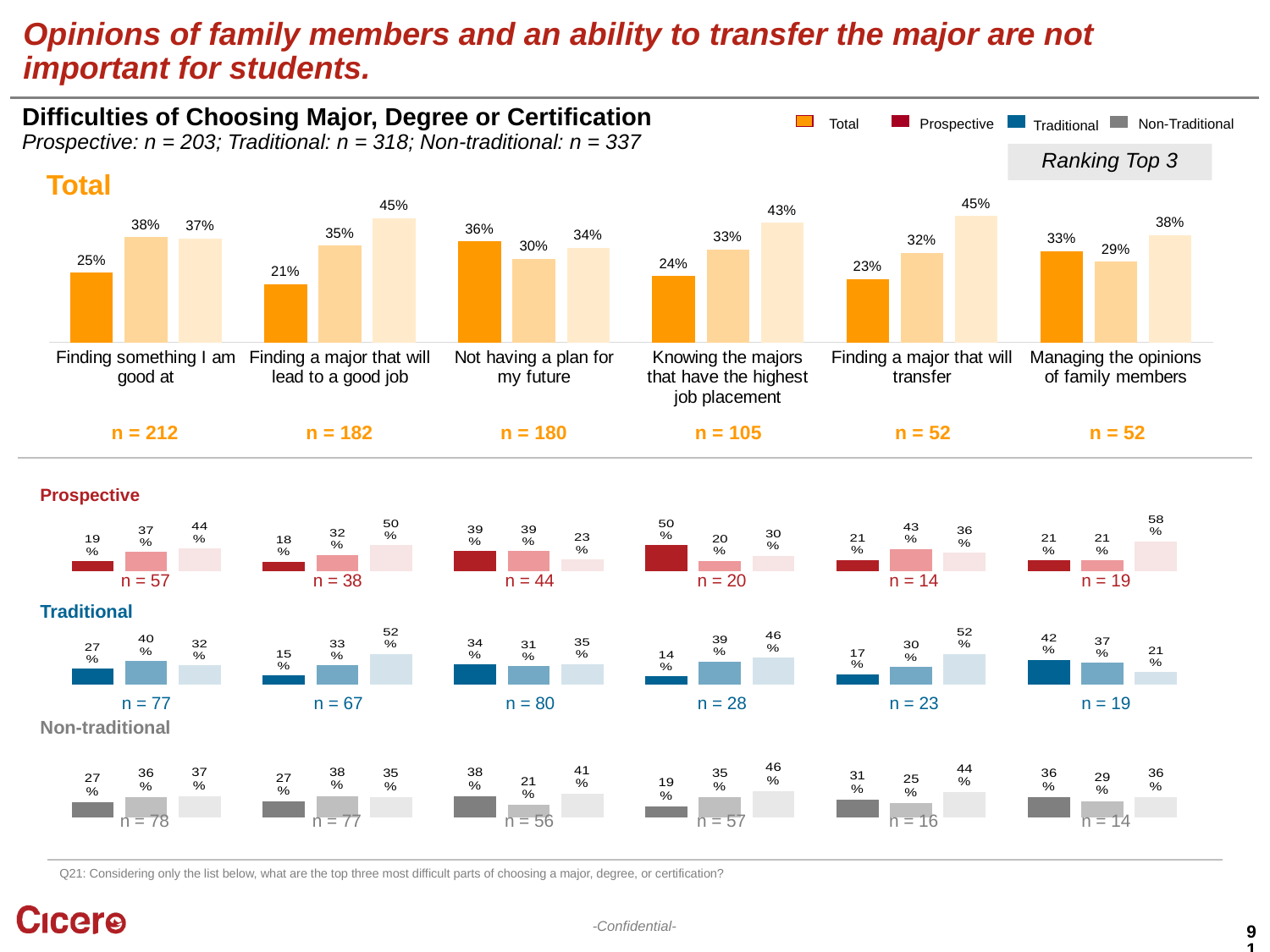
In the Prospective row, what is the value of the first (darkest red) bar for "Knowing the majors that have the highest job placement"? 50% How many entries does the legend at the top of the slide list? 4 In the Total chart, what is the difference between the first-bar values for "Not having a plan for my future" and "Finding something I am good at"? 11 percentage points In the Total chart, what is the n value shown under "Finding a major that will transfer"? n = 52 In the Total chart, what is the value of the third (lightest) bar for "Finding a major that will lead to a good job"? 45% In the Total chart, which category has the highest value for the first (darkest orange) bar? Not having a plan for my future In the Total chart, which has the larger first-bar value: "Managing the opinions of family members" or "Knowing the majors that have the highest job placement"? Managing the opinions of family members How many categories are shown along the x axis of the Total chart? 6 What kind of chart is used to show the Total results? Bar chart In the Total chart, which category has the lowest value for the first (darkest orange) bar? Finding a major that will lead to a good job What is the title of the chart on the slide? Difficulties of Choosing Major, Degree or Certification In the Total chart, what is the value of the first (darkest orange) bar for "Not having a plan for my future"? 36%